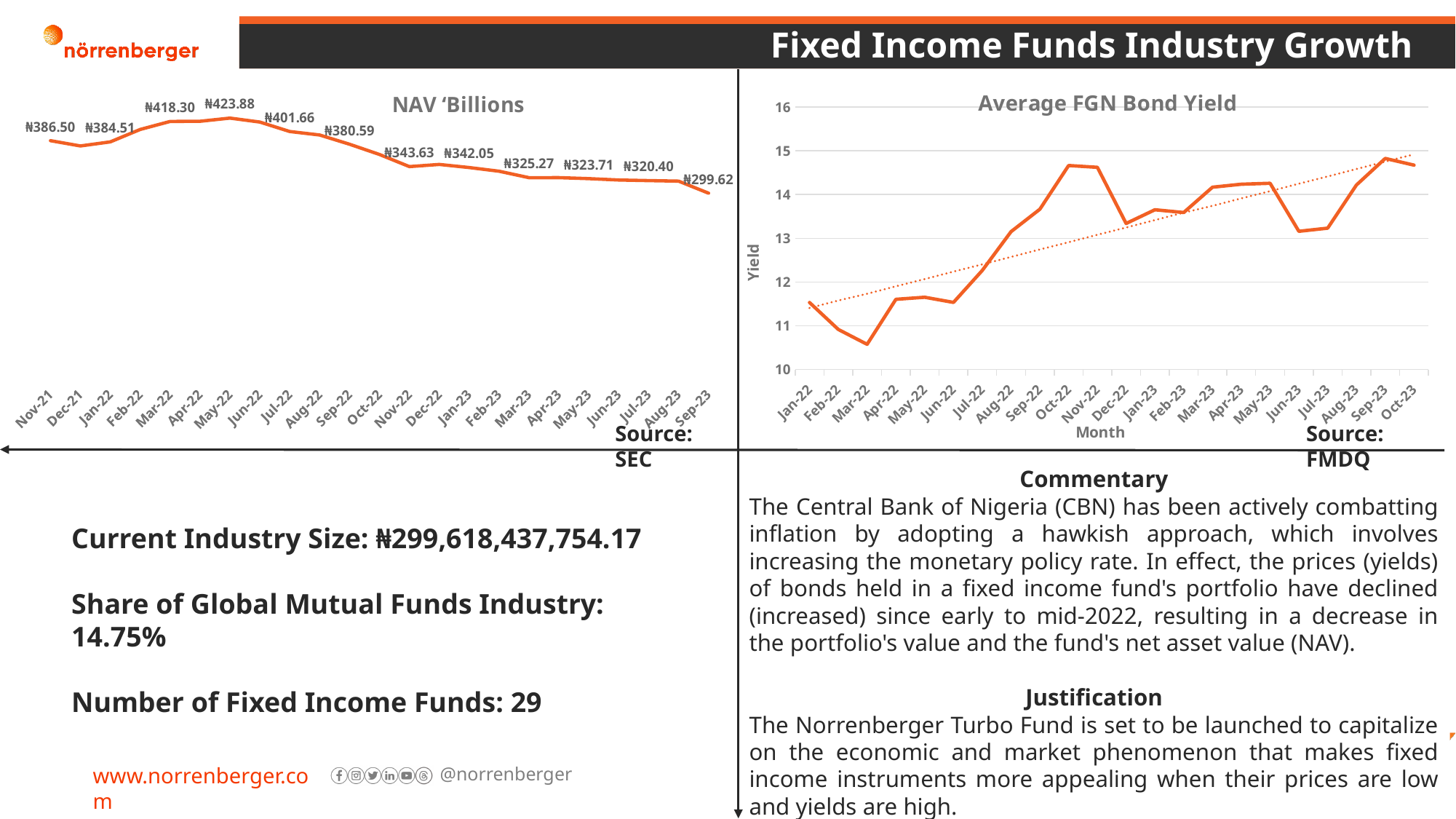
In the NAV 'Billions chart, what is the highest labelled NAV value? ₦423.88 In the NAV 'Billions chart, what is the NAV value for Sep-23? ₦299.62 How many months are shown on the x axis of the NAV 'Billions chart? 23 In the NAV 'Billions chart, what is the lowest labelled NAV value? ₦299.62 In the NAV 'Billions chart, what is the NAV value for Nov-21? ₦386.50 In the NAV 'Billions chart, what is the difference between the Nov-21 value (₦386.50) and the Sep-23 value (₦299.62)? ₦86.88 In the Average FGN Bond Yield chart, is the yield for Oct-22 greater or less than 14? greater What is the label on the y axis of the Average FGN Bond Yield chart? Yield What type of chart is the NAV 'Billions chart on the left? Line chart In the Average FGN Bond Yield chart, is the yield for Mar-22 greater or less than 11? less In the Average FGN Bond Yield chart, which month has the lowest yield? Mar-22 In the NAV 'Billions chart, does the NAV generally rise or fall from Jul-22 to Sep-23? Fall